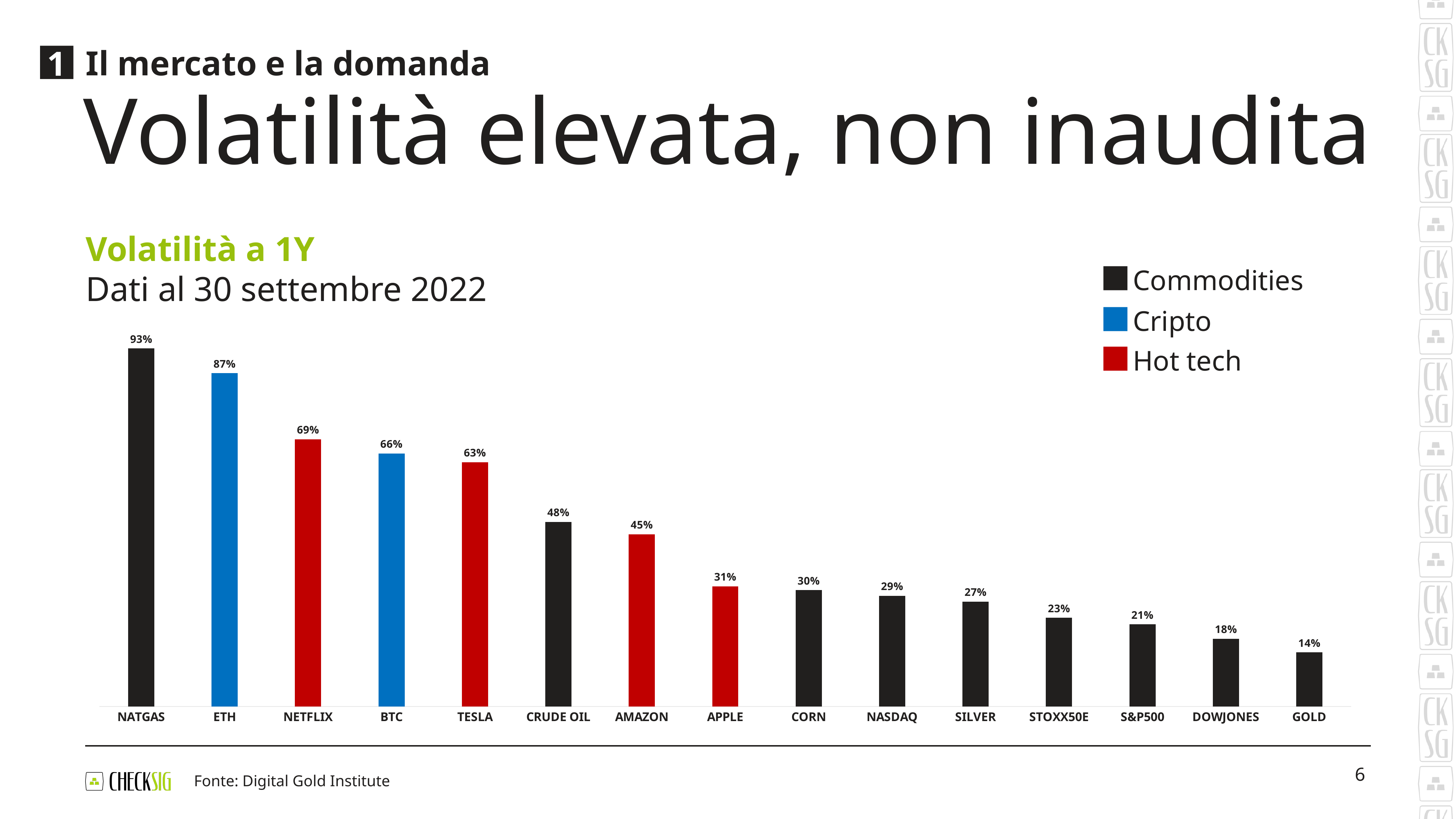
Which category has the highest volatility value? NATGAS Which legend entry is shown in blue? Cripto How many series does the legend list? 3 Which has a larger value, TESLA or AMAZON? TESLA What is the difference between the values for NETFLIX and APPLE? 38% Which category has the lowest volatility value? GOLD What is the value shown for GOLD? 14% What is the value shown for CRUDE OIL? 48% What is the difference between the values for NATGAS and ETH? 6% How many categories are plotted on the chart? 15 What kind of chart is shown on the slide? Bar chart What is the 1Y volatility value shown for BTC? 66%